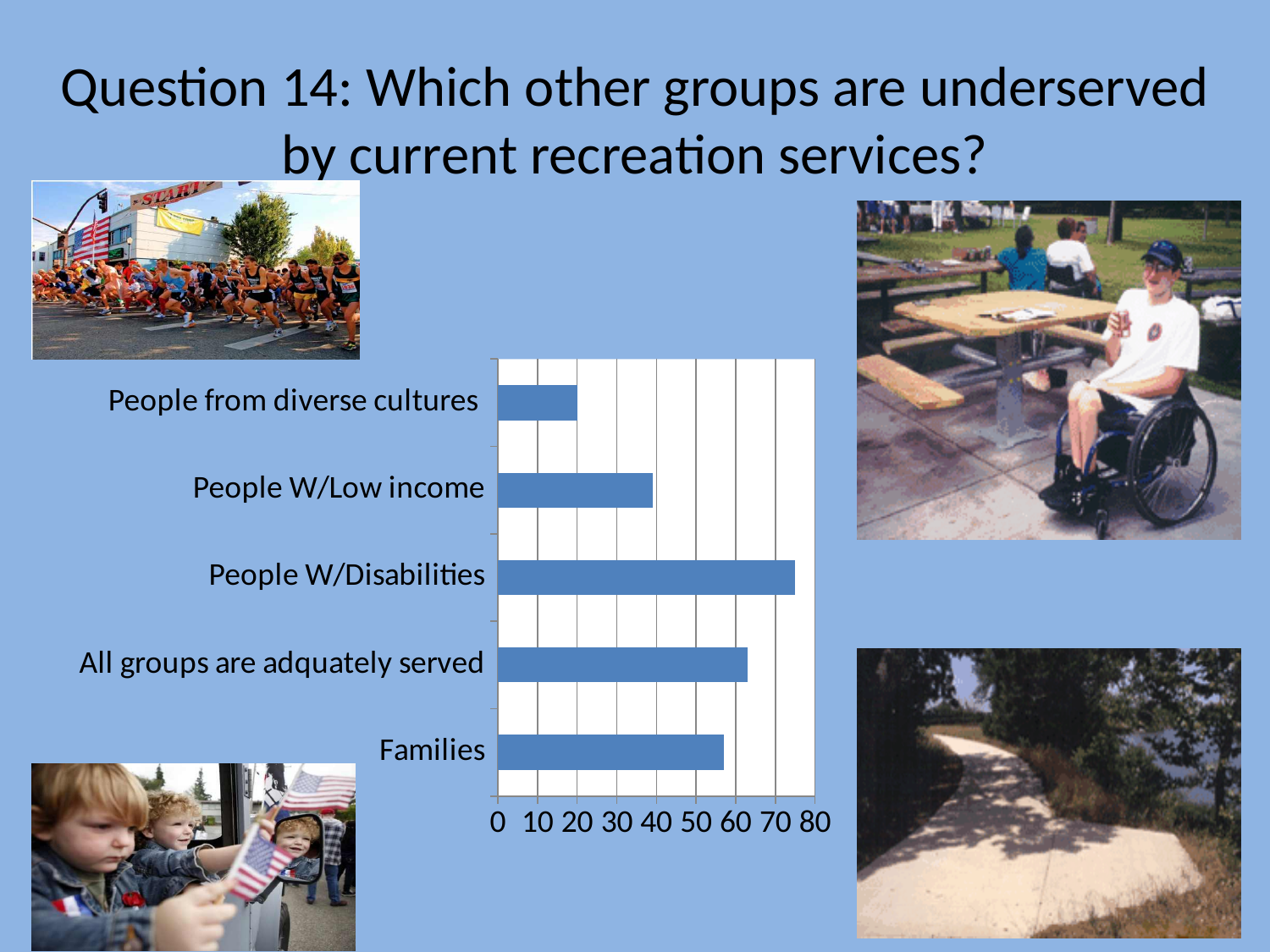
What kind of chart is shown on the slide? bar chart Which has a larger value: People W/Low income or Families? Families Which has a larger value: All groups are adquately served or People W/Disabilities? People W/Disabilities Which category has the lowest value in the bar chart? People from diverse cultures Which category has the highest value in the bar chart? People W/Disabilities Is the value for People from diverse cultures greater or less than 30? less Is the value for All groups are adquately served greater or less than 70? less How many categories does the bar chart show? 5 Is the value for People W/Low income greater or less than 50? less What is the highest value shown on the horizontal axis of the bar chart? 80